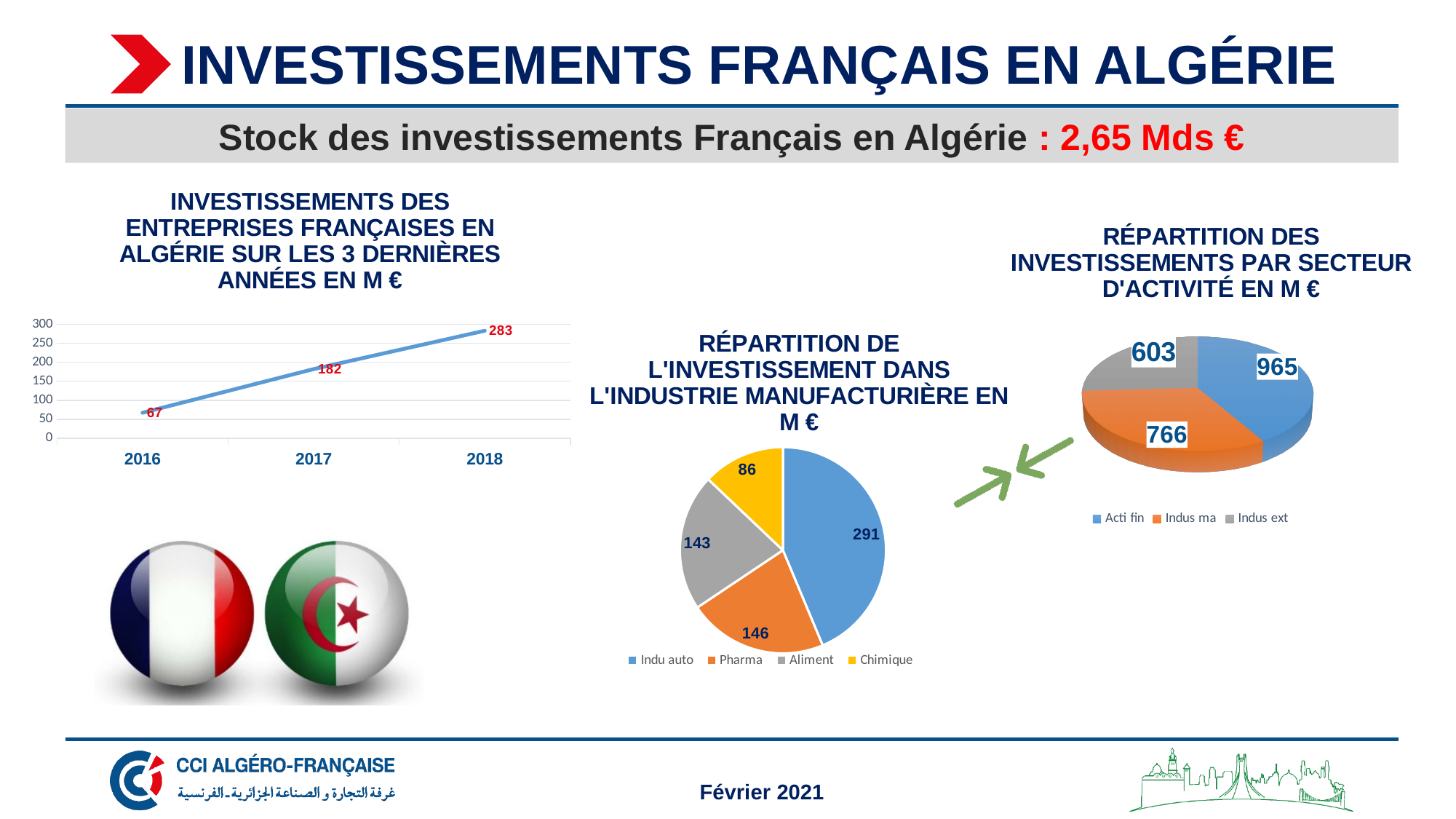
In the pie chart 'Répartition de l'investissement dans l'industrie manufacturière en M €', which category has the largest value? Indu auto In the pie chart 'Répartition des investissements par secteur d'activité en M €', what is the value for Indus ext? 603 In the line chart on the left, what is the difference between the 2018 and 2017 values? 101 In the pie chart 'Répartition de l'investissement dans l'industrie manufacturière en M €', which category has the smallest value? Chimique In the line chart 'Investissements des entreprises françaises en Algérie sur les 3 dernières années en M €', what is the value for 2018? 283 How many years are plotted in the line chart on the left? 3 How many categories does the legend of the pie chart 'Répartition de l'investissement dans l'industrie manufacturière en M €' list? 4 What kind of chart is the chart titled 'Investissements des entreprises françaises en Algérie sur les 3 dernières années en M €'? line chart In the pie chart 'Répartition des investissements par secteur d'activité en M €', which is larger, Acti fin or Indus ma? Acti fin In the pie chart 'Répartition de l'investissement dans l'industrie manufacturière en M €', what is the value for Pharma? 146 In the line chart on the left, do the values rise or fall from 2016 to 2018? rise In the line chart on the left, what is the value for 2016? 67